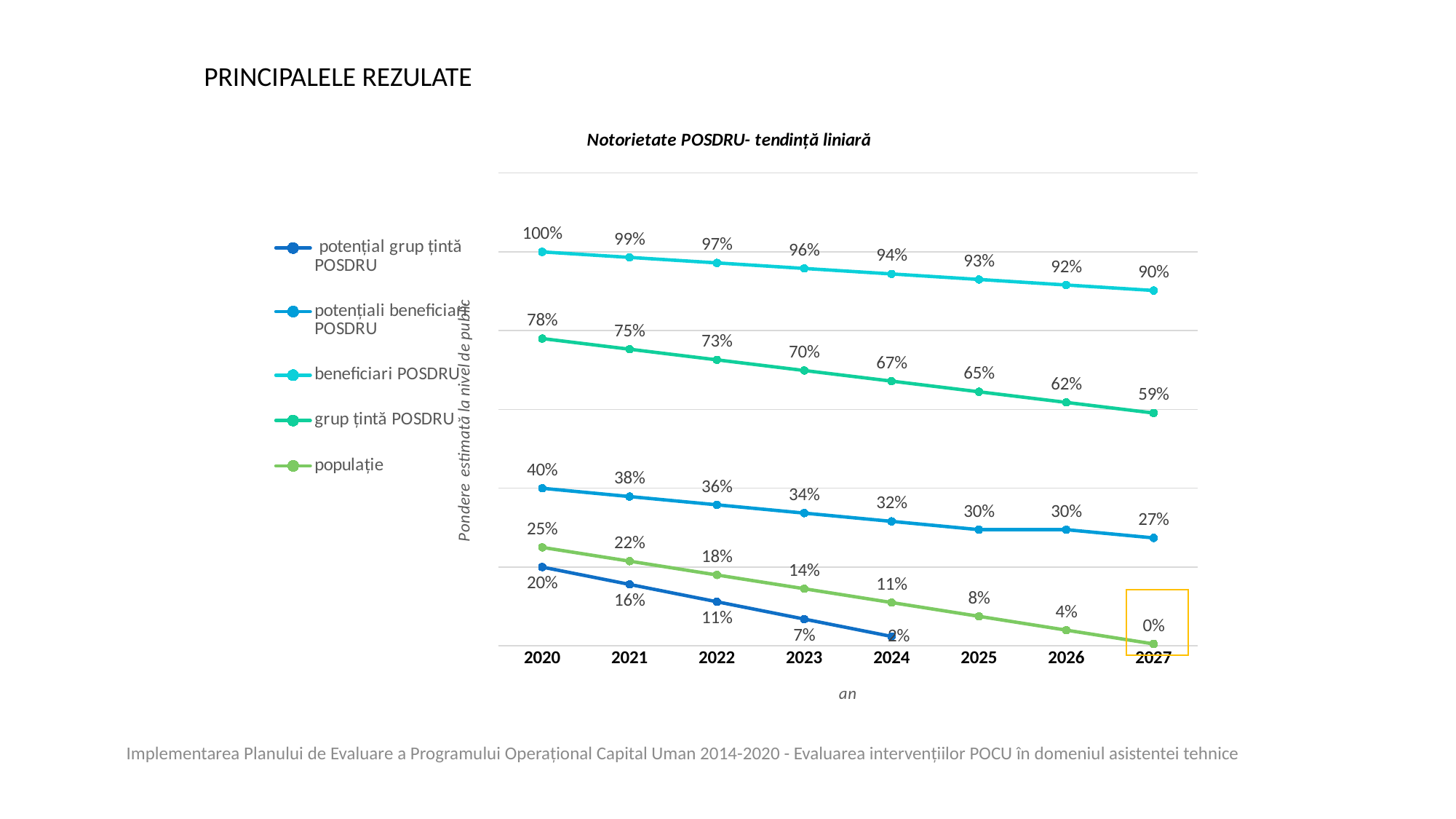
How many series does the legend list? 5 What kind of chart is shown on the slide? line chart What is the value for beneficiari POSDRU in 2027? 90% What is the value for potențiali beneficiari POSDRU in 2020? 40% Which series has the lowest value in 2027? populație Which series has the highest value in 2020? beneficiari POSDRU What is the difference between the grup țintă POSDRU values in 2020 and 2027? 19% Do the values for populație rise or fall from 2020 to 2027? fall How many years are shown on the x axis? 8 What is the value for populație in 2025? 8% What is the value for grup țintă POSDRU in 2023? 70% What is the title of the chart? Notorietate POSDRU- tendință liniară